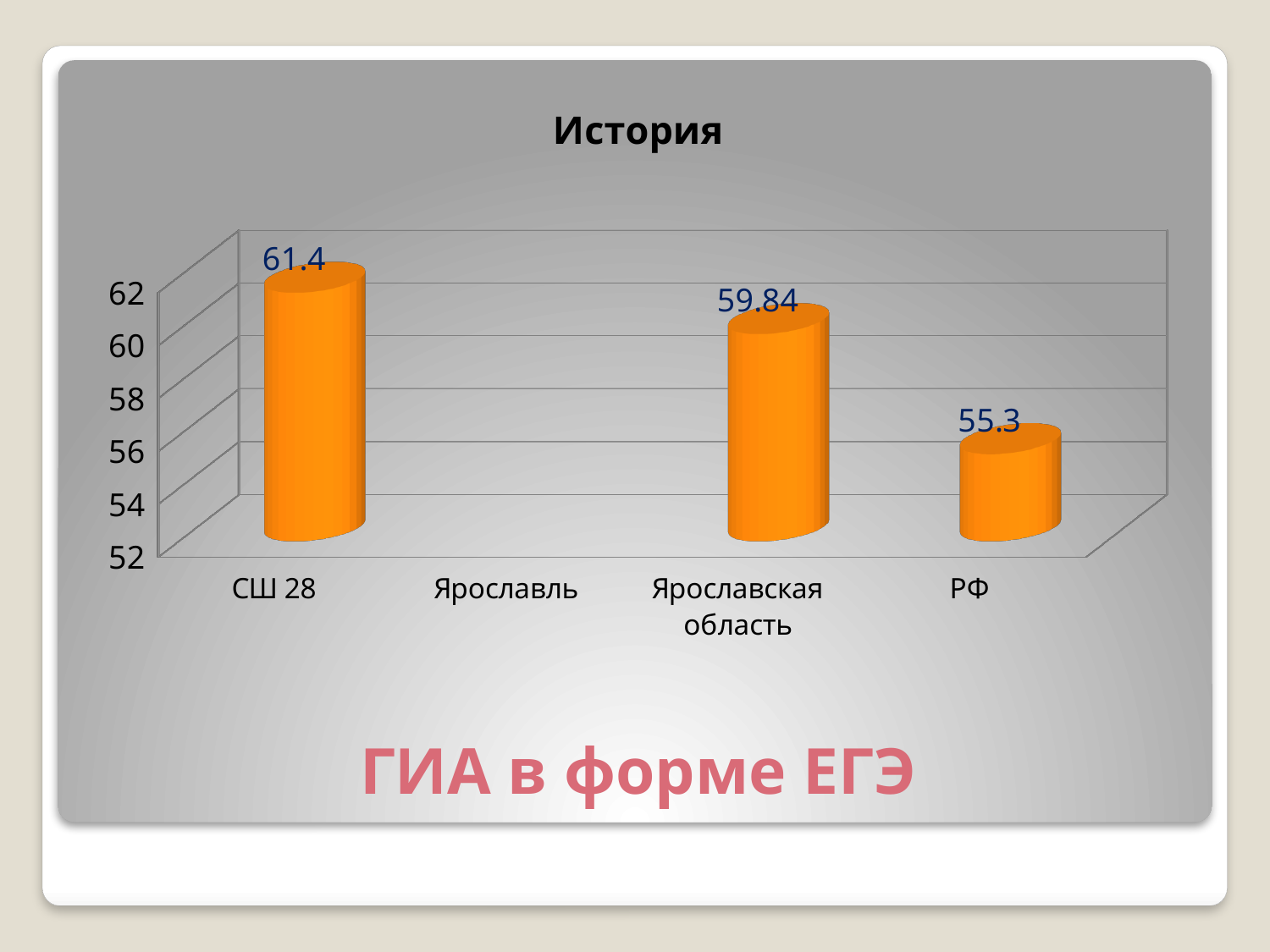
What is the difference between the values for Ярославская область and РФ? 4.54 Which category with a plotted bar has the lowest value? РФ What is the value for СШ 28? 61.4 What is the value for Ярославская область? 59.84 Which is larger, the value for СШ 28 or the value for Ярославская область? СШ 28 Is the value for РФ greater or less than 56? less What is the difference between the values for СШ 28 and РФ? 6.1 How many bars are plotted on the chart? 3 Which category has the highest value? СШ 28 What kind of chart is shown on the slide? bar chart What is the title of the chart? История What is the value for РФ? 55.3